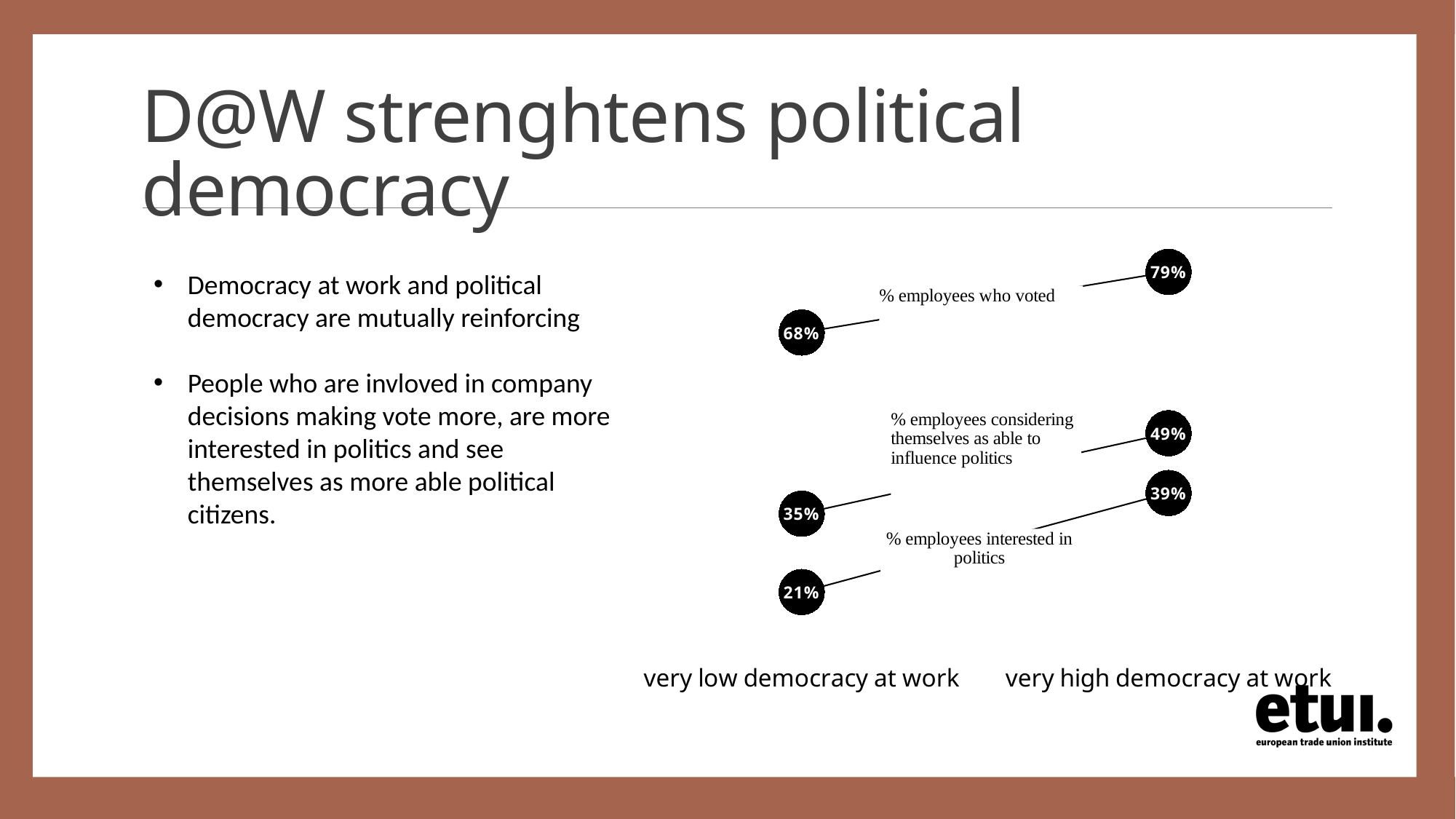
What is the difference between the very high and very low democracy at work values for '% employees interested in politics'? 18% Do the values for each indicator rise or fall from very low to very high democracy at work? rise Which indicator has the lowest value at very low democracy at work? % employees interested in politics What is the value for '% employees who voted' at very high democracy at work? 79% What is the value for '% employees considering themselves as able to influence politics' at very high democracy at work? 49% What is the value for '% employees interested in politics' at very low democracy at work? 21% What is the value for '% employees who voted' at very low democracy at work? 68% What is the difference between the very high and very low democracy at work values for '% employees considering themselves as able to influence politics'? 14% Which indicator has the highest value at very high democracy at work? % employees who voted What is the value for '% employees interested in politics' at very high democracy at work? 39% How many indicators are plotted on the chart? 3 Which is larger: '% employees considering themselves as able to influence politics' at very low democracy at work, or '% employees interested in politics' at very high democracy at work? % employees interested in politics at very high democracy at work